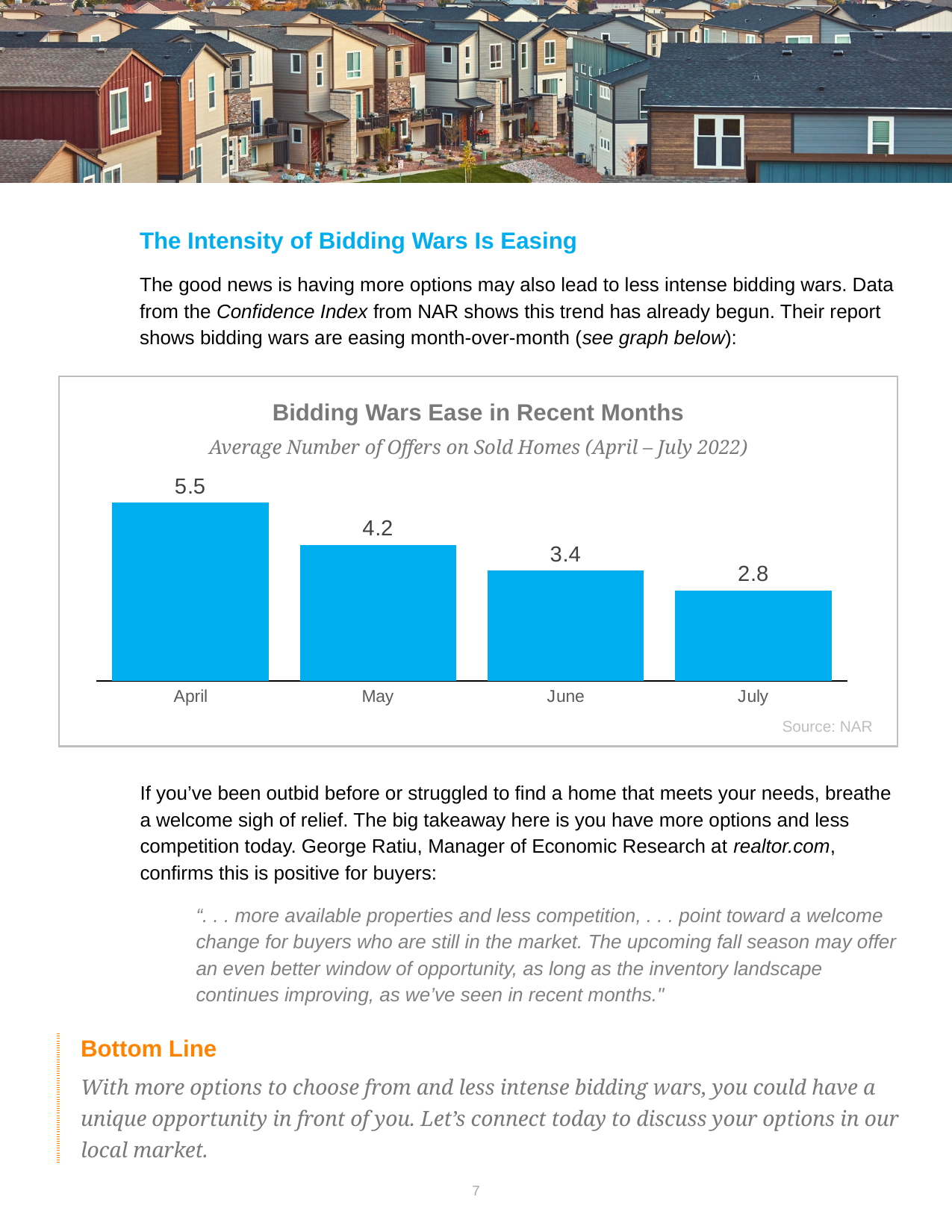
Which month has the lowest average number of offers? July Which month has a higher value, May or June? May What is the source cited for the chart? NAR Do the values rise or fall from April to July? Fall What is the average number of offers on sold homes in April? 5.5 What is the value shown for June? 3.4 What type of chart is shown? Bar chart What is the difference between the May and June values? 0.8 Which month has the highest average number of offers? April What is the average number of offers on sold homes in July? 2.8 How many months are shown on the chart? 4 What is the difference between the April and July values? 2.7